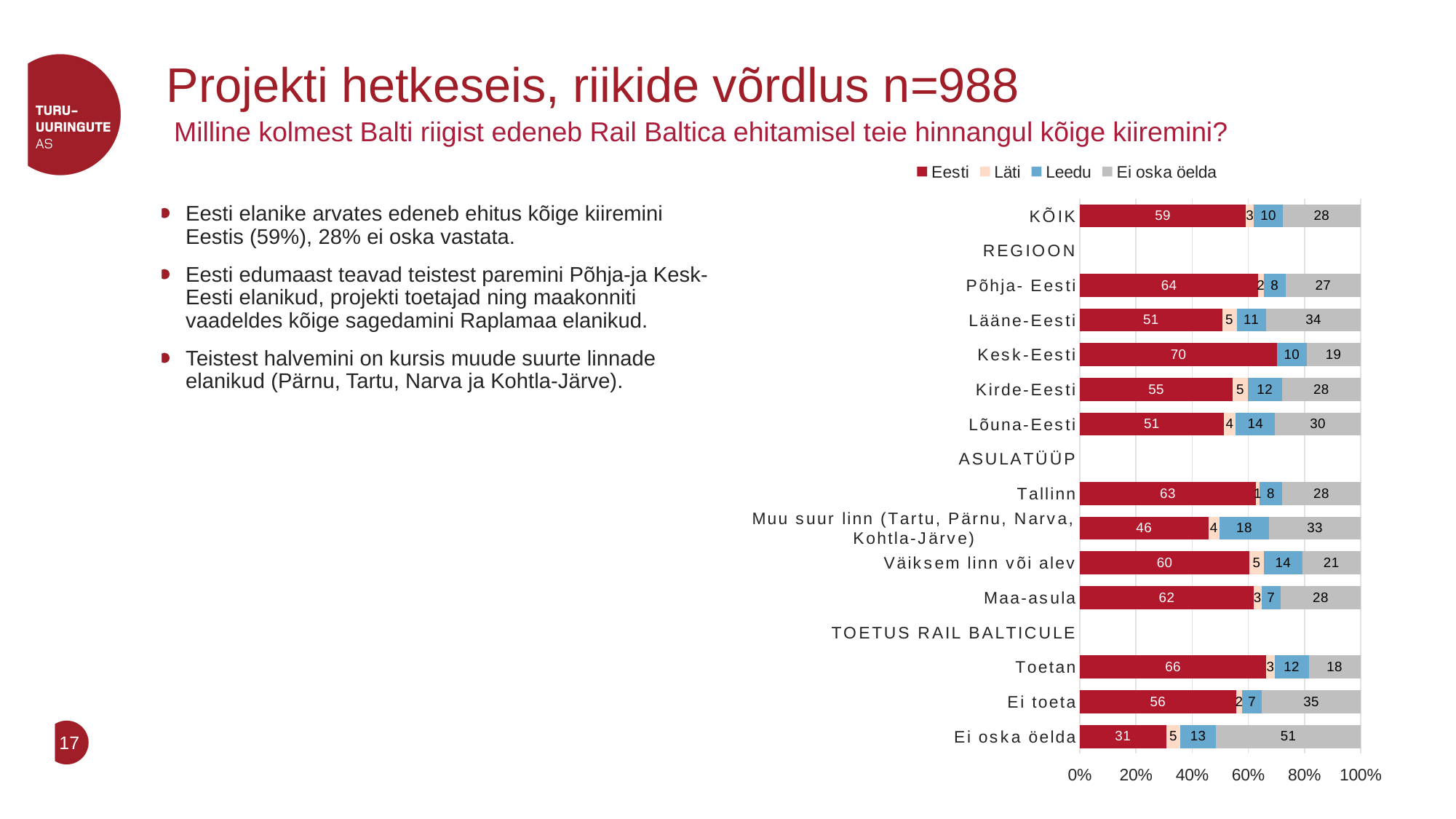
Which has a larger Ei oska öelda value, Kesk-Eesti or Lõuna-Eesti? Lõuna-Eesti What is the Eesti value for KÕIK? 59 What is the Ei oska öelda value for Lääne-Eesti? 34 Which category has the highest Eesti value? Kesk-Eesti What is the Leedu value for Muu suur linn (Tartu, Pärnu, Narva, Kohtla-Järve)? 18 What is the Leedu value for Toetan? 12 What is the Läti value for Tallinn? 1 What is the difference between the Eesti values for Toetan and Ei toeta? 10 Which category has the lowest Eesti value? Ei oska öelda Which series is shown in grey in the chart? Ei oska öelda How many series does the chart legend list? 4 What type of chart is shown on the slide? stacked bar chart